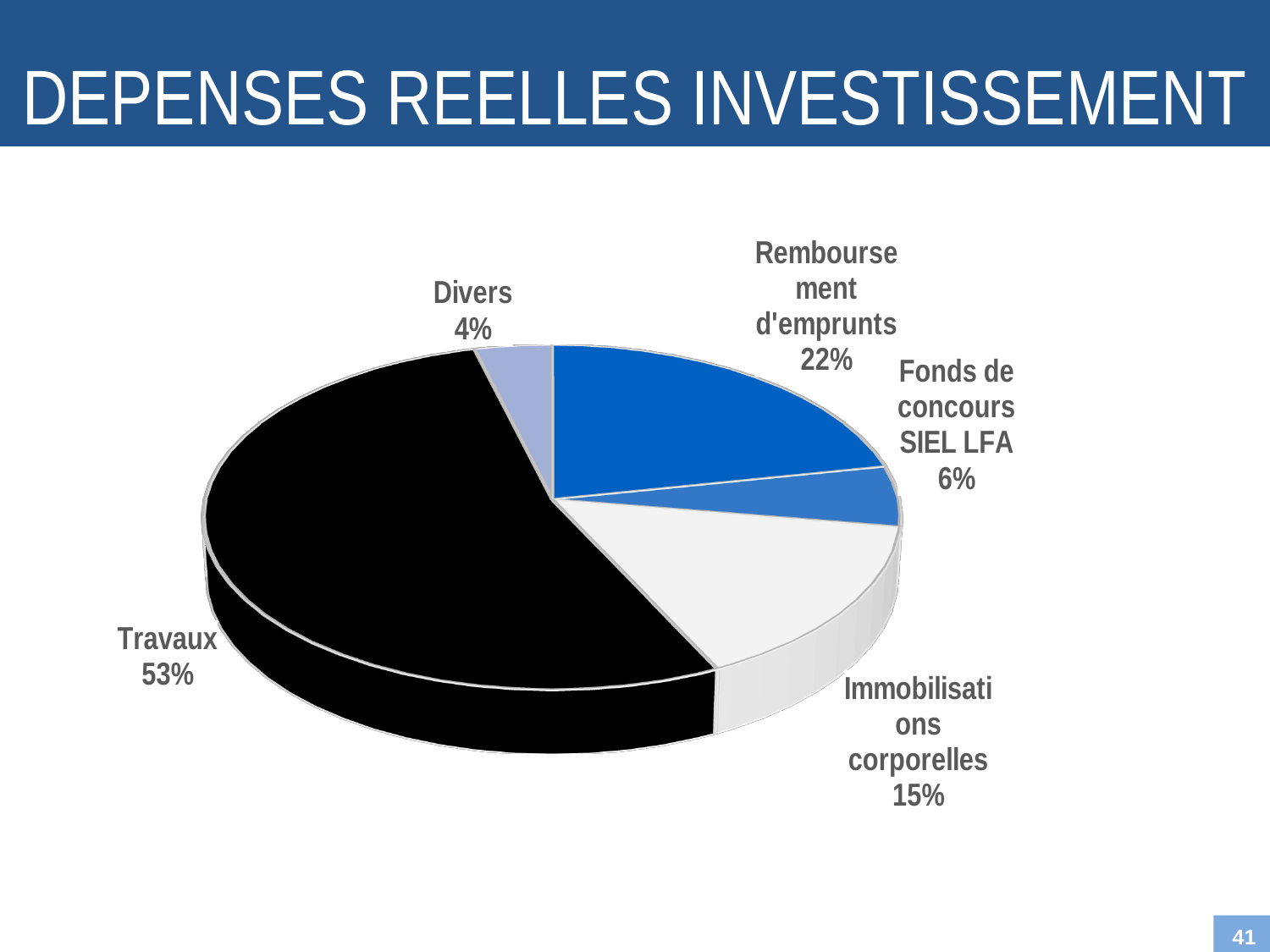
What is the difference in percentage points between Travaux and Remboursement d'emprunts? 31 Which category has the largest share of the pie? Travaux What is the value for Divers? 4% What is the title of the slide? DEPENSES REELLES INVESTISSEMENT What share of the pie does Travaux represent? 53% Which is larger, Immobilisations corporelles or Fonds de concours SIEL LFA? Immobilisations corporelles Which category has the smallest share of the pie? Divers What is the value for Immobilisations corporelles? 15% What kind of chart is shown on the slide? Pie chart How many categories are shown in the pie chart? 5 What percentage is shown for Remboursement d'emprunts? 22% What percentage is shown for Fonds de concours SIEL LFA? 6%